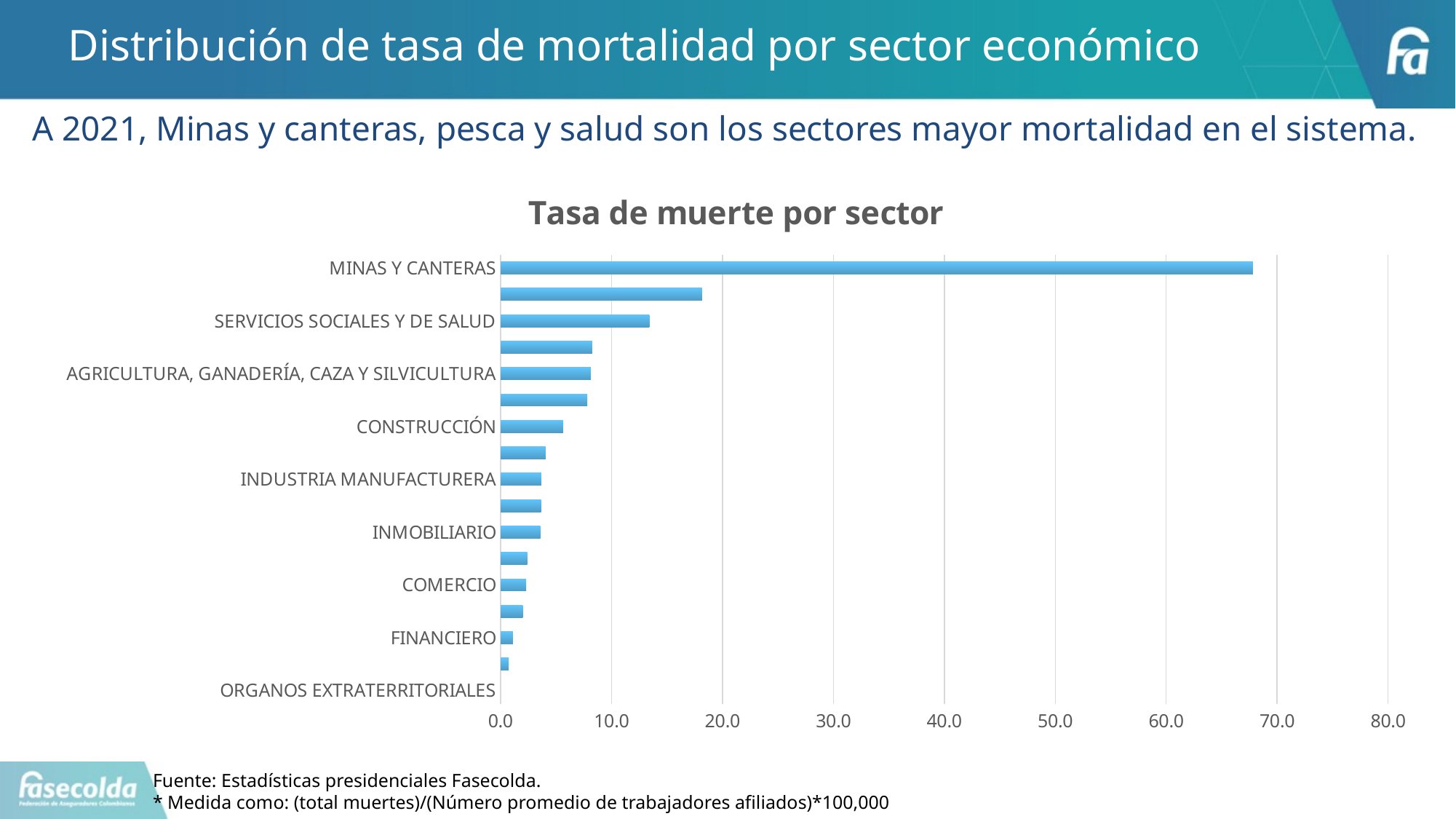
Which sector has the highest death rate in the chart? MINAS Y CANTERAS What kind of chart is shown on the slide? Bar chart Which labeled sector has the lowest death rate in the chart? ORGANOS EXTRATERRITORIALES Which has a higher death rate, FINANCIERO or INDUSTRIA MANUFACTURERA? INDUSTRIA MANUFACTURERA What is the title of the chart? Tasa de muerte por sector Is the value for AGRICULTURA, GANADERÍA, CAZA Y SILVICULTURA greater or less than 10.0? less Which has a higher death rate, MINAS Y CANTERAS or SERVICIOS SOCIALES Y DE SALUD? MINAS Y CANTERAS Is the value for CONSTRUCCIÓN greater or less than 10.0? less Is the value for SERVICIOS SOCIALES Y DE SALUD greater or less than 10.0? greater Which has a higher death rate, CONSTRUCCIÓN or COMERCIO? CONSTRUCCIÓN Do the bar values increase or decrease going from the top of the chart to the bottom? decrease